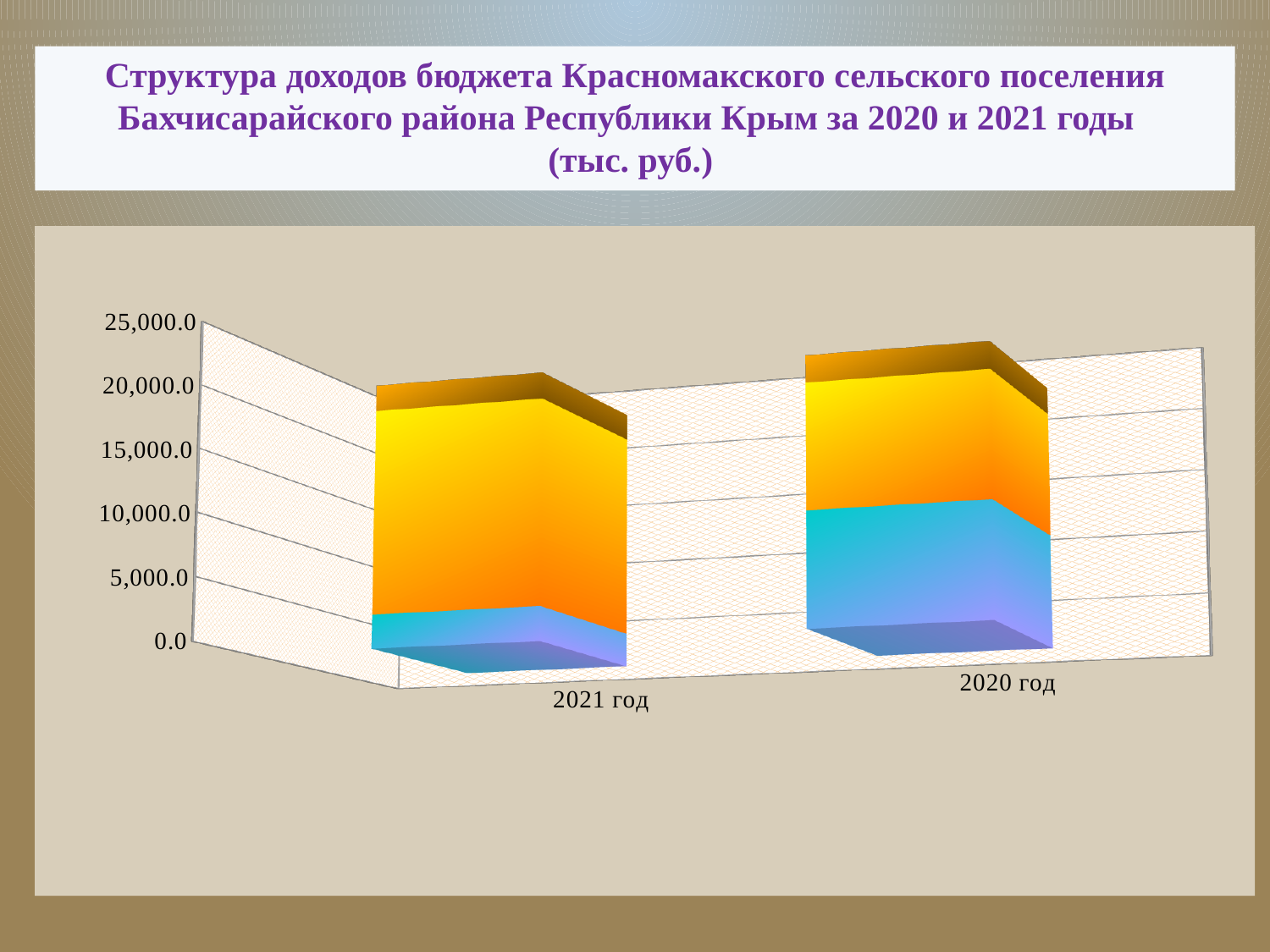
What is the highest value shown on the vertical axis of the chart? 25,000.0 How many categories are shown on the x axis of the chart? 2 Which year has the smaller blue segment, 2021 год or 2020 год? 2021 год Which categories are shown on the x axis of the chart? 2021 год and 2020 год Is the blue segment of the bar for 2021 год greater or less than 5,000.0? less Is the total height of the bar for 2020 год greater or less than 15,000.0? greater Is the blue segment of the bar for 2020 год greater or less than 5,000.0? greater What kind of chart is shown on the slide? bar chart